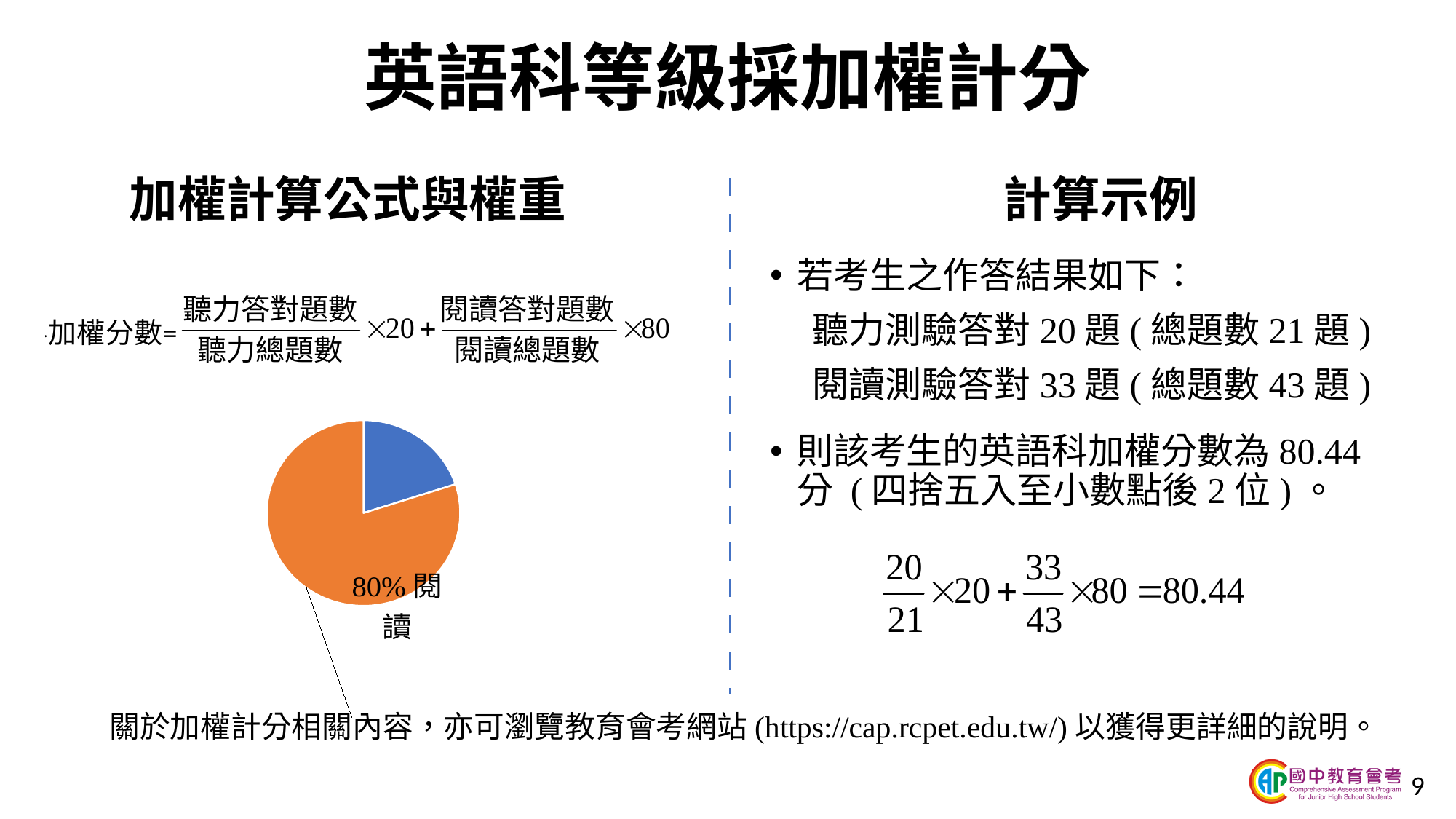
What kind of chart is shown on the slide? pie chart How many slices does the pie chart have? 2 Is the share of the blue slice in the pie chart greater or less than 50%? less Is the share of the 閱讀 slice greater or less than 50%? greater What colour is the 閱讀 slice in the pie chart? orange Which slice is larger in the pie chart, the orange slice or the blue slice? the orange slice What is the value shown for 閱讀 in the pie chart? 80% Which slice of the pie chart has a data label? 閱讀 What share of the pie chart does the 閱讀 slice take? 80% Which slice of the pie chart is the largest? 閱讀